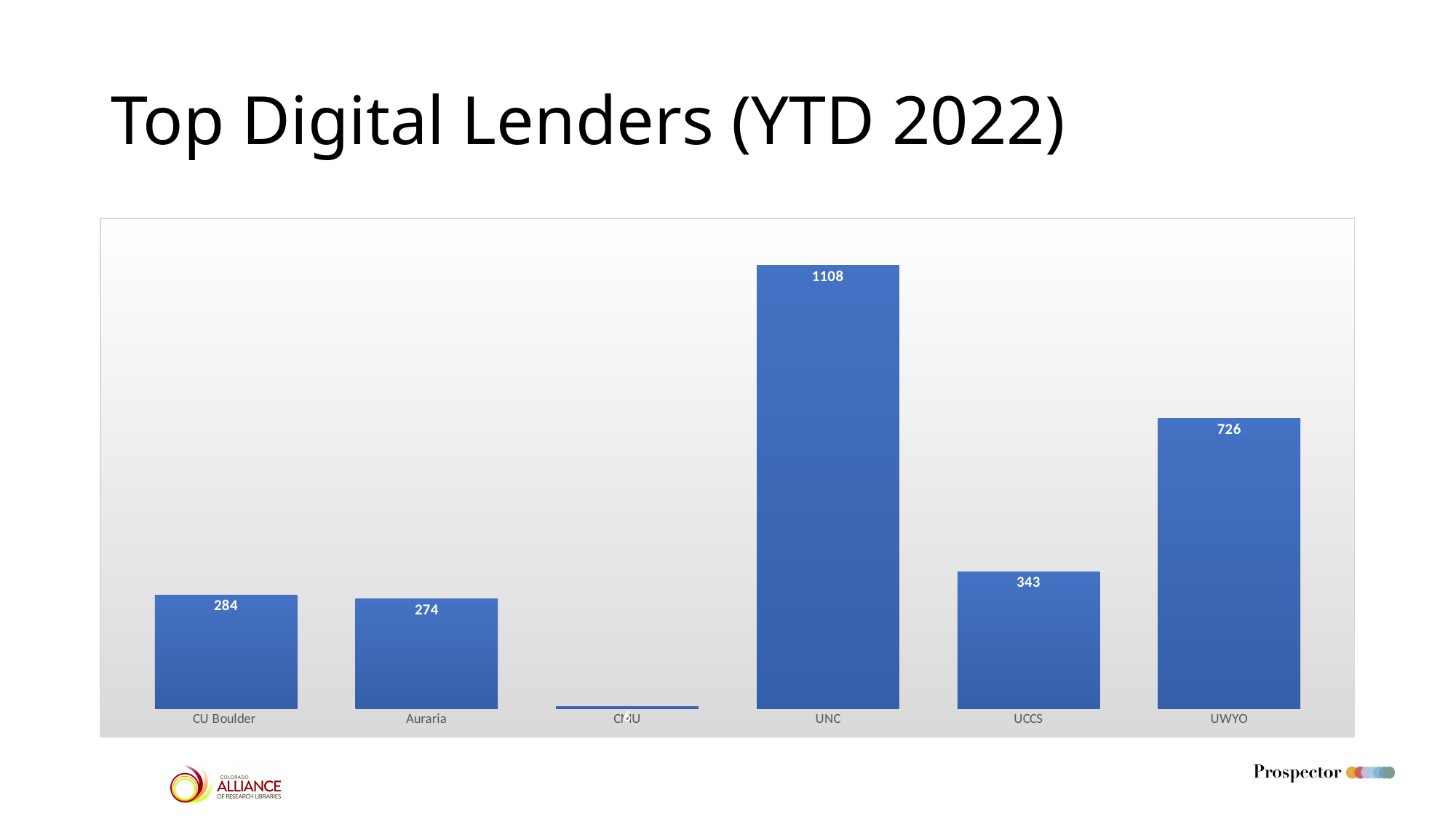
What is the difference between the values for CU Boulder and Auraria? 10 What is the value for CU Boulder? 284 What is the value for UNC? 1108 Which category has the lowest value? CMU What is the value for UCCS? 343 What is the difference between the values for UNC and UWYO? 382 Which is larger, the value for UCCS or the value for Auraria? UCCS How many categories are shown in the chart? 6 Which category has the highest value? UNC What kind of chart is shown on the slide? Bar chart What is the value for UWYO? 726 What is the title of the slide? Top Digital Lenders (YTD 2022)